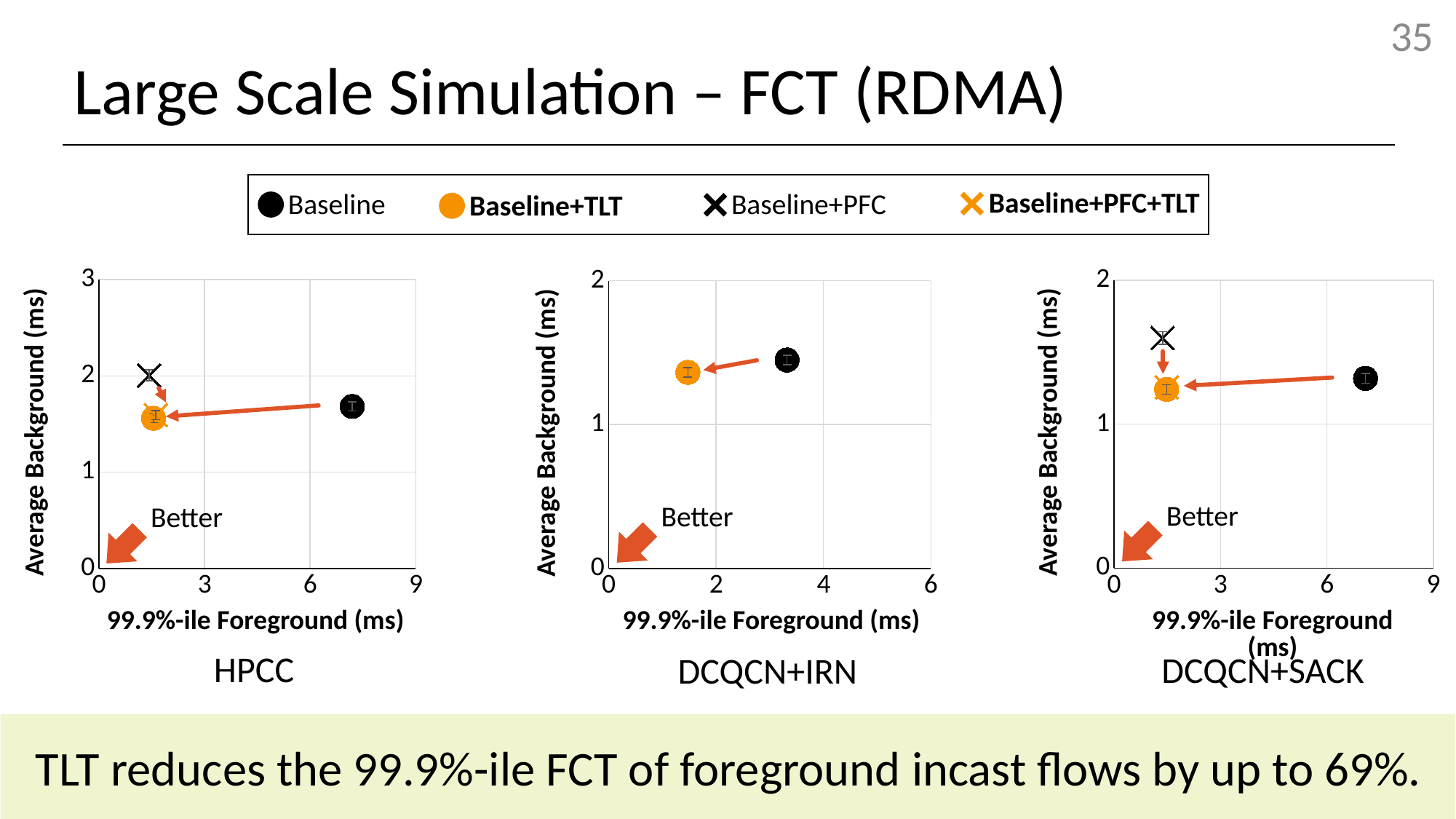
How many series does the shared legend list? 4 What is the label of the x axis on the DCQCN+IRN chart? 99.9%-ile Foreground (ms) In the DCQCN+SACK chart, is the 99.9%-ile Foreground value for Baseline greater or less than 6? greater In the DCQCN+IRN chart, is the 99.9%-ile Foreground value for Baseline+TLT greater or less than 2? less In the DCQCN+IRN chart, is the 99.9%-ile Foreground value for Baseline greater or less than 2? greater In the HPCC chart, which has the larger 99.9%-ile Foreground value, Baseline or Baseline+TLT? Baseline What kind of chart is the HPCC chart? scatter chart How many charts are shown on the slide? 3